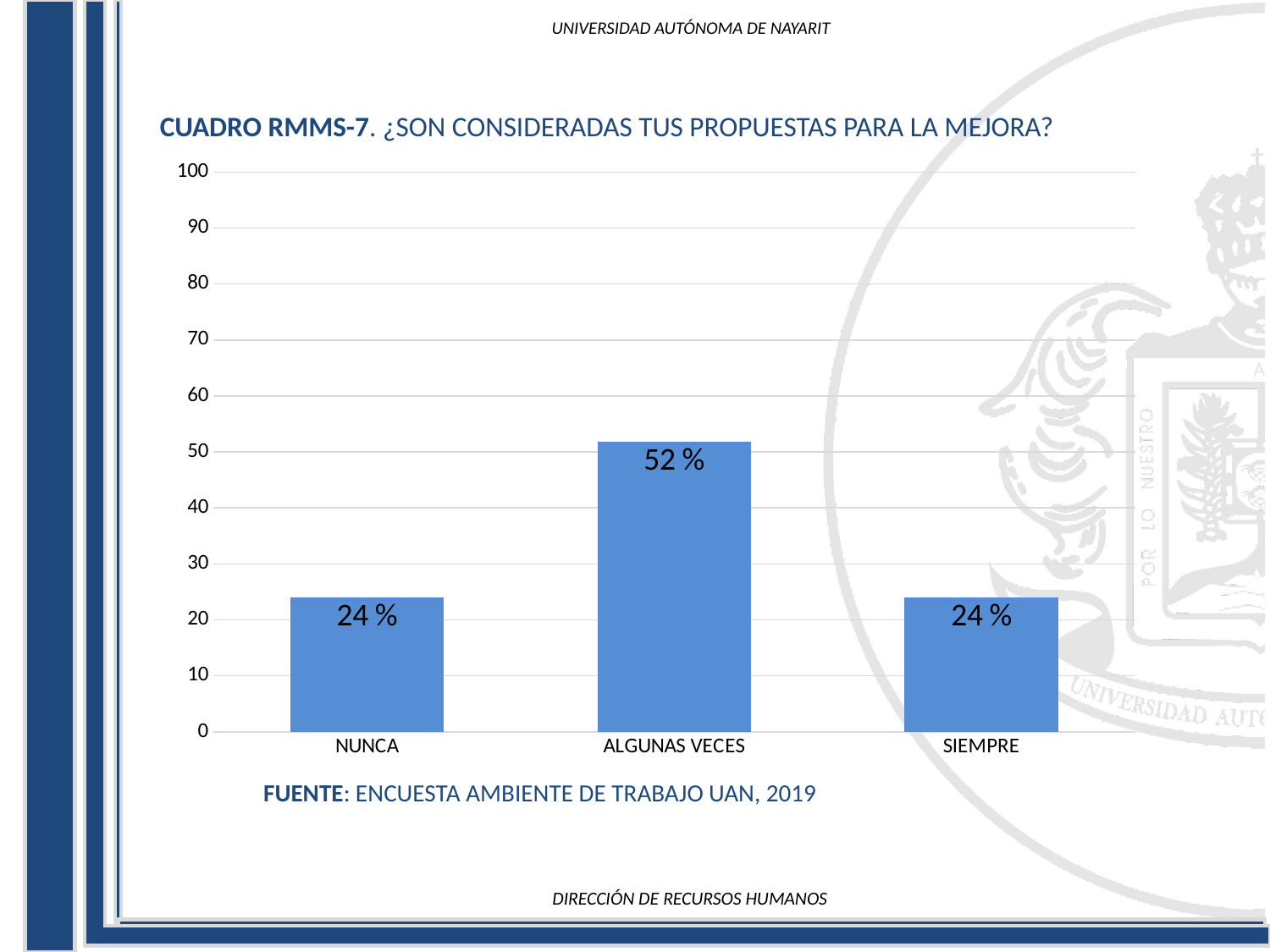
Which is larger, the value for ALGUNAS VECES or the value for SIEMPRE? ALGUNAS VECES What is the value for SIEMPRE? 24 % What source is cited below the chart? ENCUESTA AMBIENTE DE TRABAJO UAN, 2019 What is the value for ALGUNAS VECES? 52 % What is the total of the values for NUNCA and SIEMPRE? 48 % Which category has the highest value? ALGUNAS VECES How many categories are shown on the x axis? 3 What is the value for NUNCA? 24 % What is the difference between the values for ALGUNAS VECES and NUNCA? 28 % Is the value for NUNCA greater or less than 30? less What kind of chart is shown on the slide? bar chart Is the value for ALGUNAS VECES greater or less than 50? greater